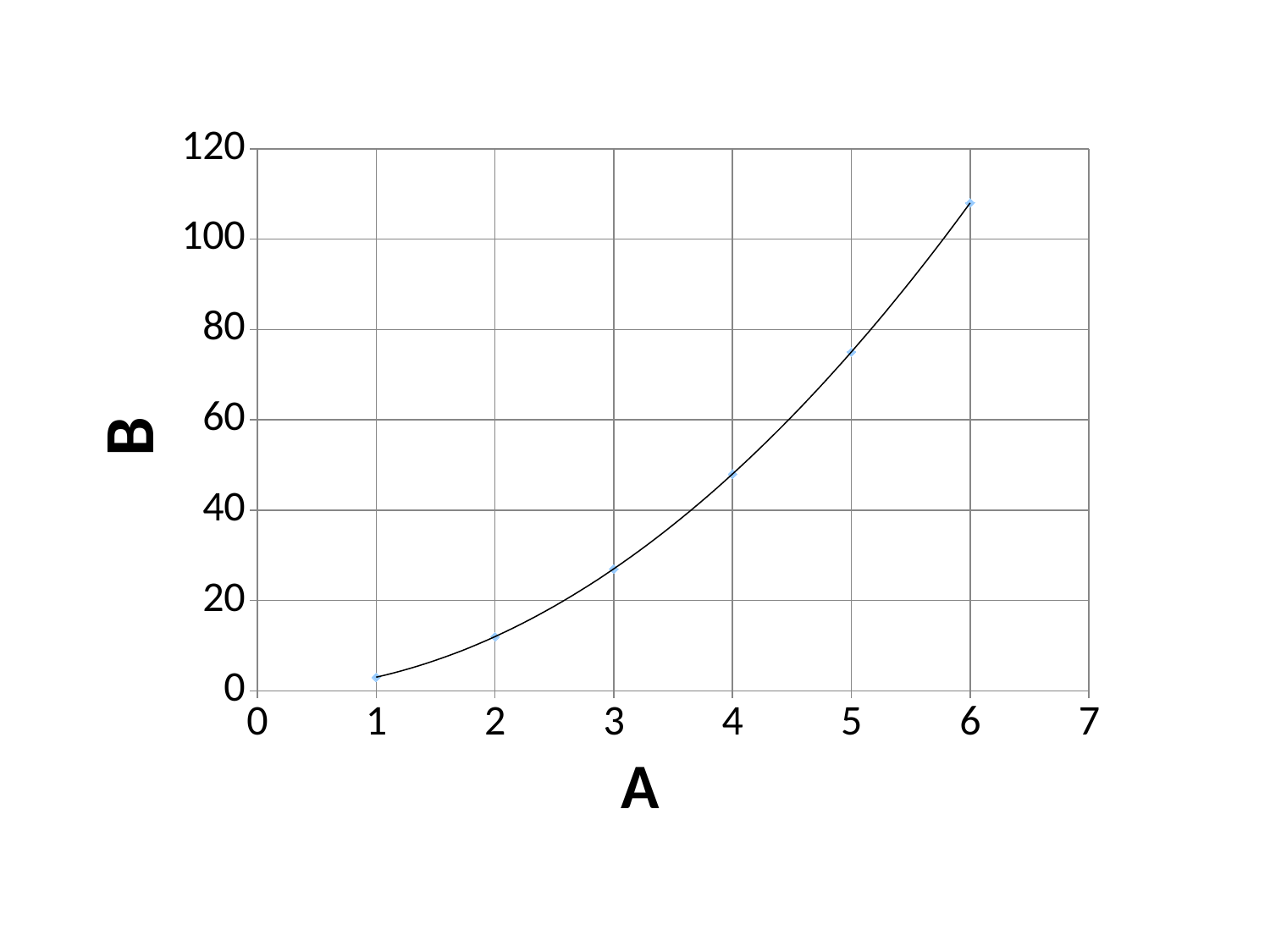
Is the value of B at A = 2 greater or less than 20? less At which value of A is B highest? 6 What is the title of the vertical axis? B Is the value of B at A = 4 greater or less than 40? greater What kind of chart is shown on the slide? scatter chart with a smooth curve Which is larger, the value of B at A = 5 or at A = 3? A = 5 Is the value of B at A = 5 greater or less than 80? less How many data points are plotted on the chart? 6 At which value of A is B lowest? 1 Do the values of B rise or fall as A increases? rise